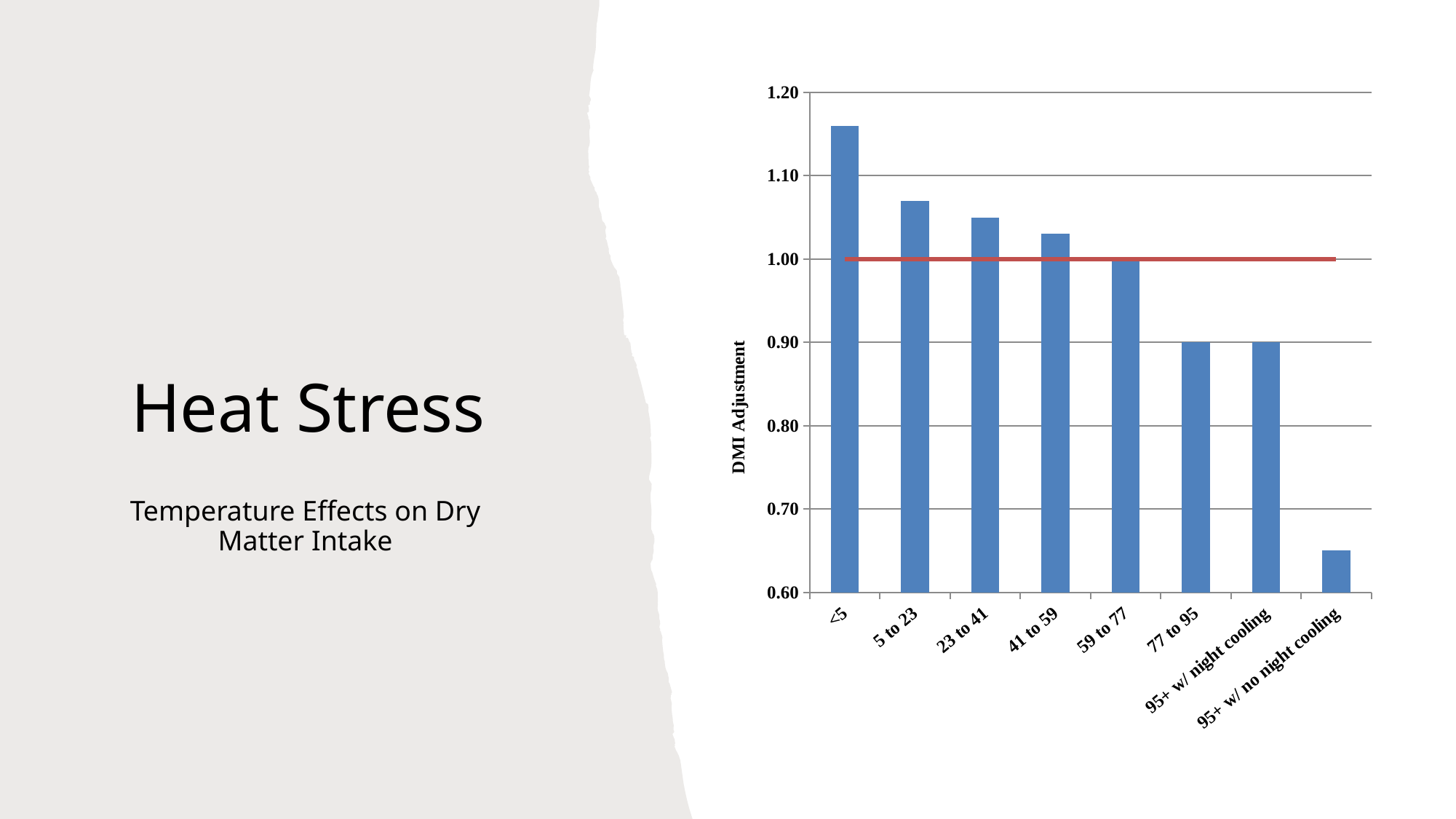
What is the DMI Adjustment for the 77 to 95 category? 0.90 What is the DMI Adjustment for the 95+ w/ night cooling category? 0.90 How many temperature categories are plotted on the x axis? 8 Which category has the highest DMI Adjustment? <5 Which category has the lowest DMI Adjustment? 95+ w/ no night cooling Do the DMI Adjustment values generally rise or fall moving from left to right along the x axis? fall Is the DMI Adjustment for <5 greater or less than 1.10? greater Is the DMI Adjustment for 95+ w/ no night cooling greater or less than 0.70? less What kind of chart is shown on the slide? bar chart Is the DMI Adjustment for 41 to 59 greater or less than 1.00? greater Which has a higher DMI Adjustment, <5 or 5 to 23? <5 What is the label on the vertical axis of the chart? DMI Adjustment